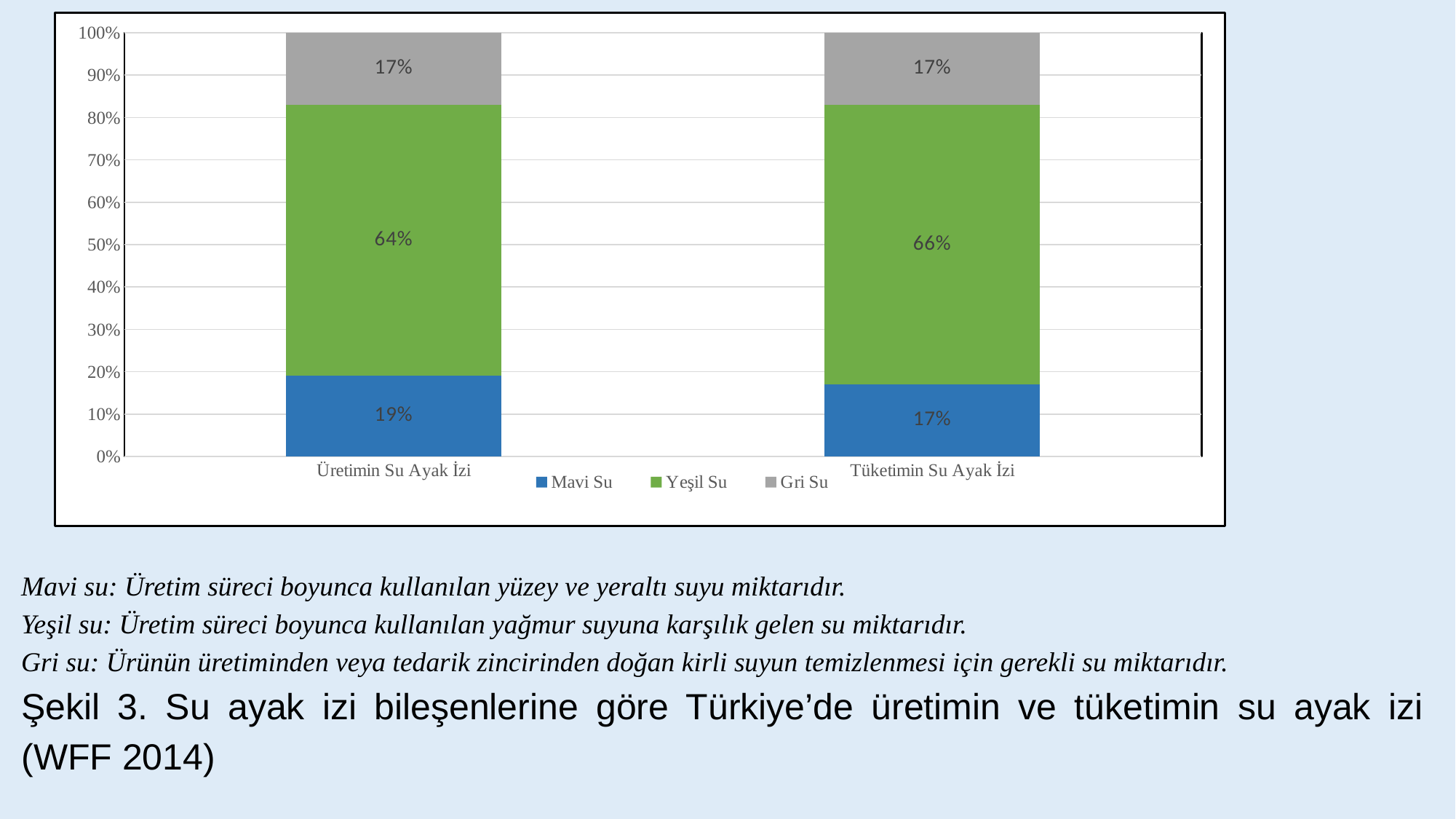
What is the Yeşil Su value for Tüketimin Su Ayak İzi? 66% Which series has the largest share in the Üretimin Su Ayak İzi bar? Yeşil Su What is the difference between the Yeşil Su values for Tüketimin Su Ayak İzi and Üretimin Su Ayak İzi? 2% What is the Mavi Su value for Üretimin Su Ayak İzi? 19% Which series has the smallest share in the Tüketimin Su Ayak İzi bar? Mavi Su and Gri Su (tied at 17%) Which category has the larger Mavi Su value, Üretimin Su Ayak İzi or Tüketimin Su Ayak İzi? Üretimin Su Ayak İzi Which colour represents Gri Su in the chart? Grey What is the Mavi Su value for Tüketimin Su Ayak İzi? 17% What kind of chart is shown on the slide? Stacked bar chart What is the Gri Su value for Üretimin Su Ayak İzi? 17% How many series does the legend list? 3 How many categories are shown on the x axis? 2